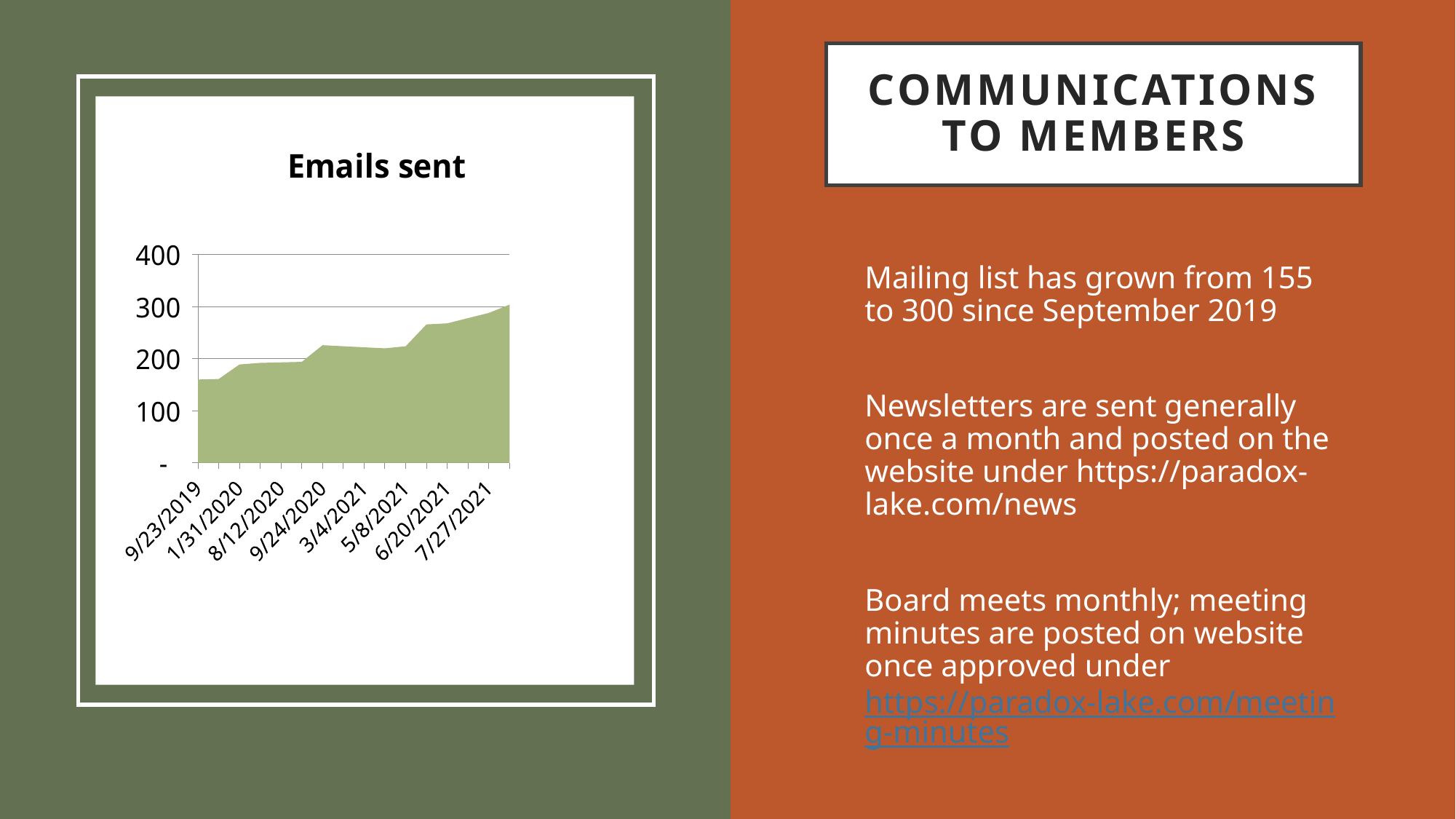
In the 'Emails sent' chart, is the value for 3/4/2021 greater or less than 200? greater In the 'Emails sent' chart, is the value for 9/24/2020 greater or less than 100? greater In the 'Emails sent' chart, which is larger, the value for 6/20/2021 or the value for 1/31/2020? 6/20/2021 What kind of chart is the 'Emails sent' chart? area chart How many date labels are shown on the x axis of the 'Emails sent' chart? 8 In the 'Emails sent' chart, which labeled date has the highest value? 7/27/2021 What is the highest value shown on the y axis of the 'Emails sent' chart? 400 In the 'Emails sent' chart, is the value for 9/23/2019 greater or less than 200? less What is the title of the chart on the slide? Emails sent In the 'Emails sent' chart, which labeled date has the lowest value? 9/23/2019 In the 'Emails sent' chart, do the values generally rise or fall from 9/23/2019 to 7/27/2021? rise